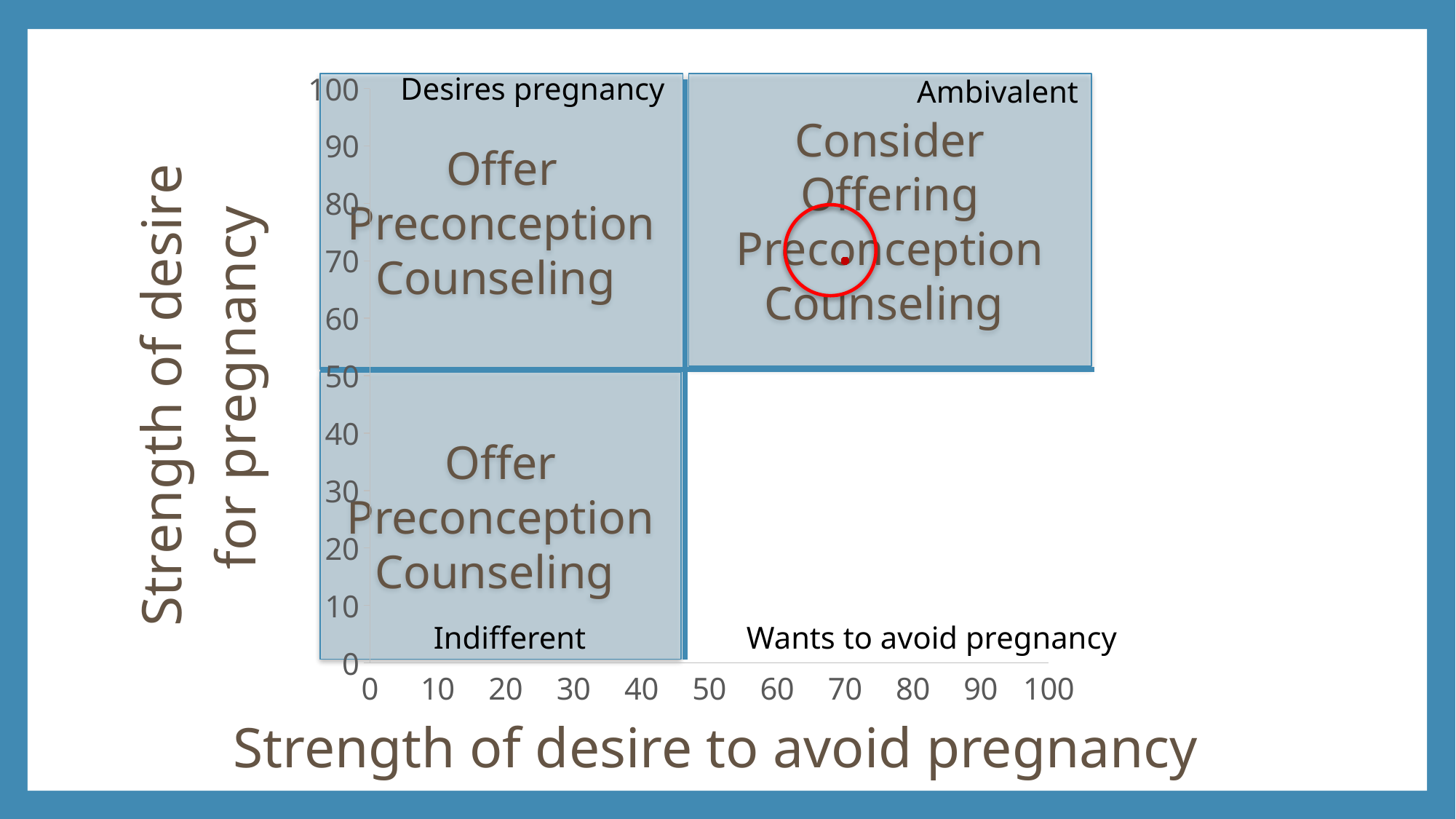
What is the maximum value shown on the x axis? 100 Is the y-axis value of the plotted point greater or less than 80? less What is the title of the x axis? Strength of desire to avoid pregnancy Is the x-axis value of the plotted point greater or less than 60? greater Is the y-axis value of the plotted point greater or less than 50? greater How many data points are plotted on the chart? 1 What is the title of the y axis? Strength of desire for pregnancy What is the y-axis value (strength of desire for pregnancy) of the plotted point? 70 What kind of chart is shown on the slide? scatter chart Which labeled quadrant does the plotted point fall in? Ambivalent What is the x-axis value (strength of desire to avoid pregnancy) of the plotted point? 70